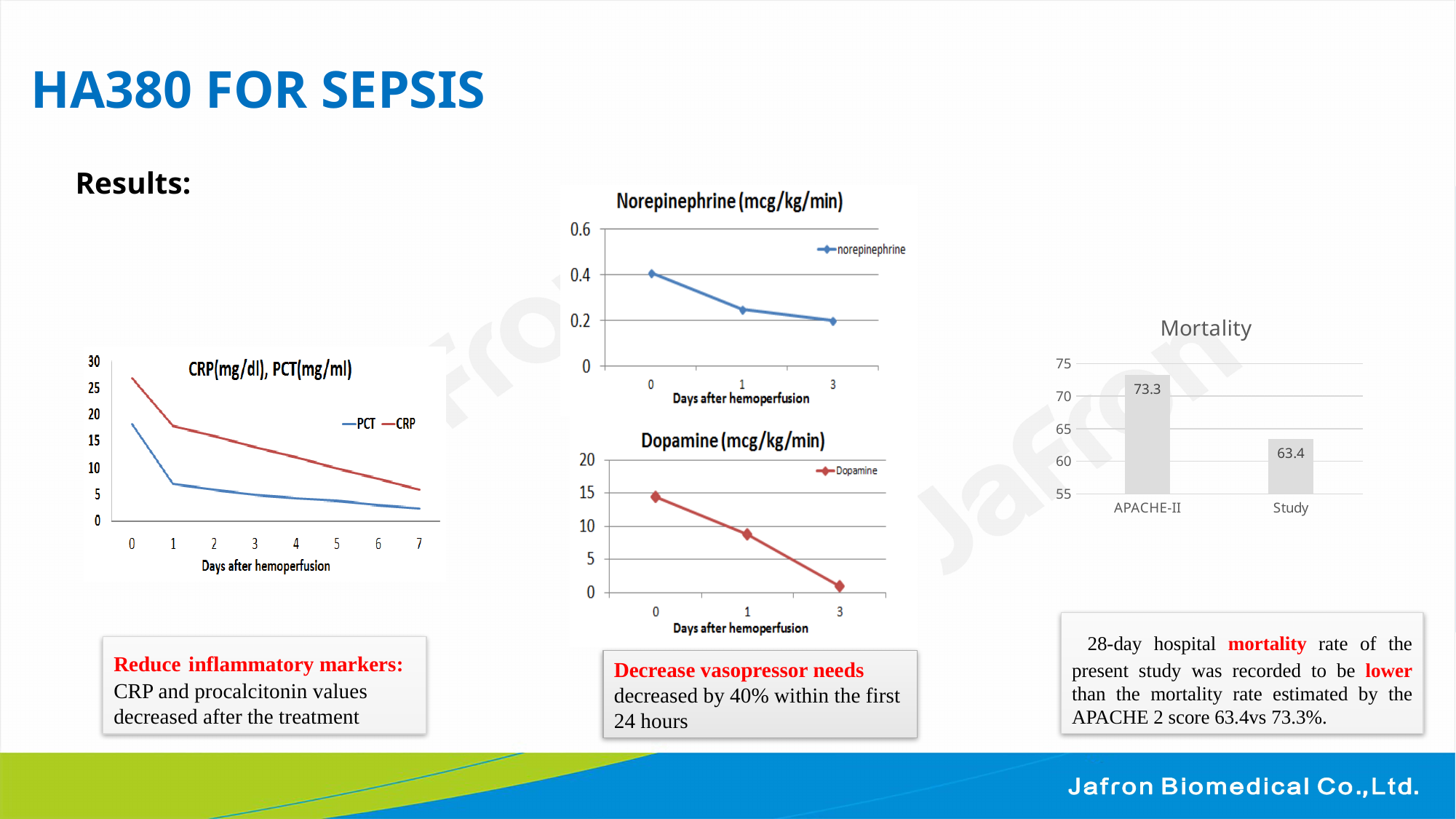
What kind of chart is the Norepinephrine (mcg/kg/min) chart? Line chart In the CRP(mg/dl), PCT(mg/ml) chart, do the CRP values rise or fall over the days after hemoperfusion? Fall In the Dopamine (mcg/kg/min) chart, how many data points are plotted? 3 In the Dopamine (mcg/kg/min) chart, is the value at day 3 greater or less than 5? less In the CRP(mg/dl), PCT(mg/ml) chart, how many series does the legend list? 2 In the Mortality chart, what is the difference between the APACHE-II and Study values? 9.9 What kind of chart is the Mortality chart? Bar chart In the Mortality chart, what is the value for Study? 63.4 In the Mortality chart, what is the value for APACHE-II? 73.3 In the Mortality chart, which category has the higher value, APACHE-II or Study? APACHE-II How many categories are shown in the Mortality chart? 2